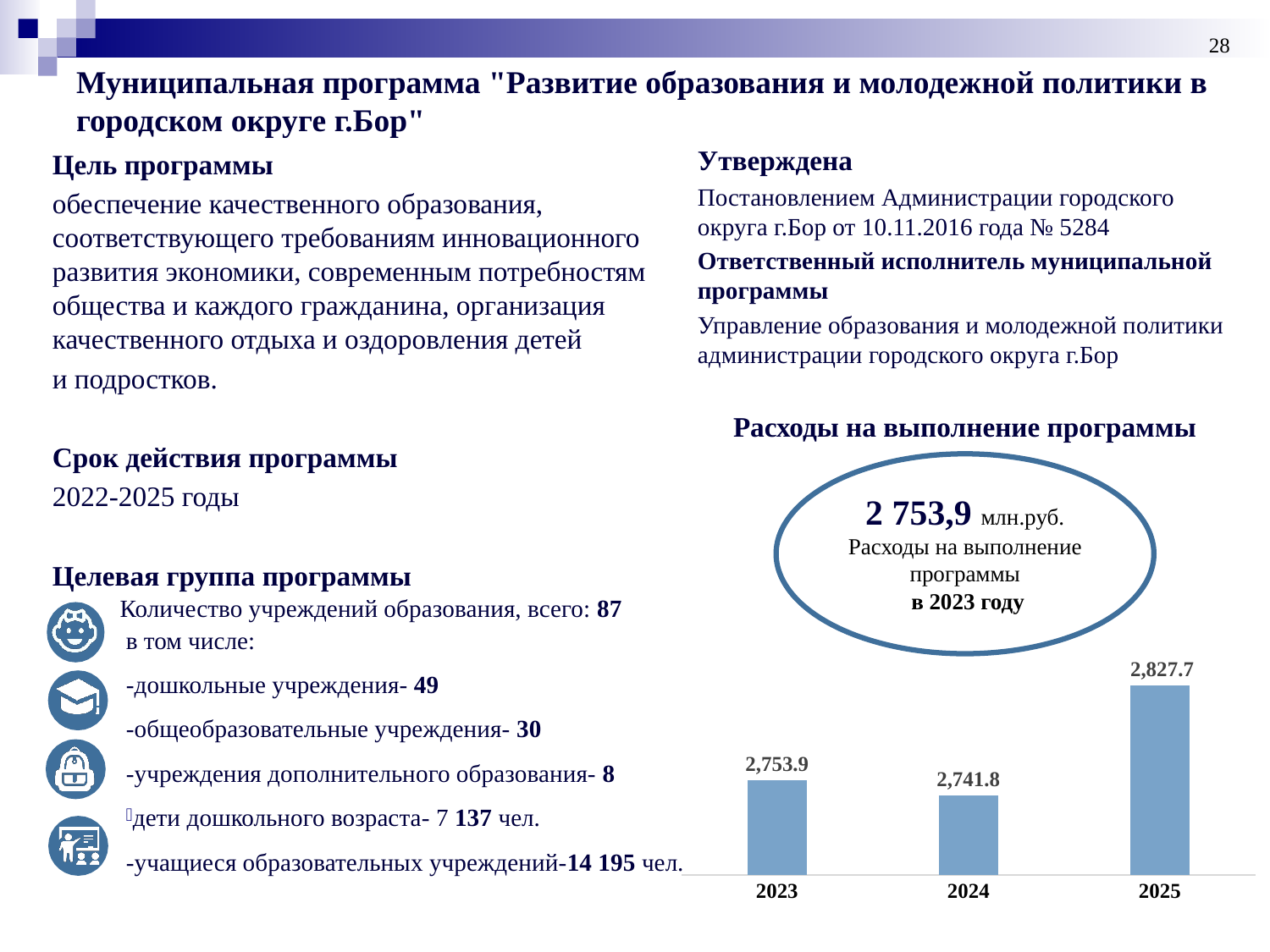
What is the value for 2024 in the chart? 2,741.8 What is the title of the chart? Расходы на выполнение программы What kind of chart is shown on the slide? bar chart Does the value rise or fall from 2024 to 2025? rise What is the difference between the values for 2023 and 2024? 12.1 Which year has the lowest value in the chart? 2024 How many years are shown in the chart? 3 What is the value for 2025 in the chart? 2,827.7 What is the difference between the values for 2025 and 2024? 85.9 Which year has the highest value in the chart? 2025 Which is larger, the value for 2023 or the value for 2025? 2025 What is the value for 2023 in the chart? 2,753.9